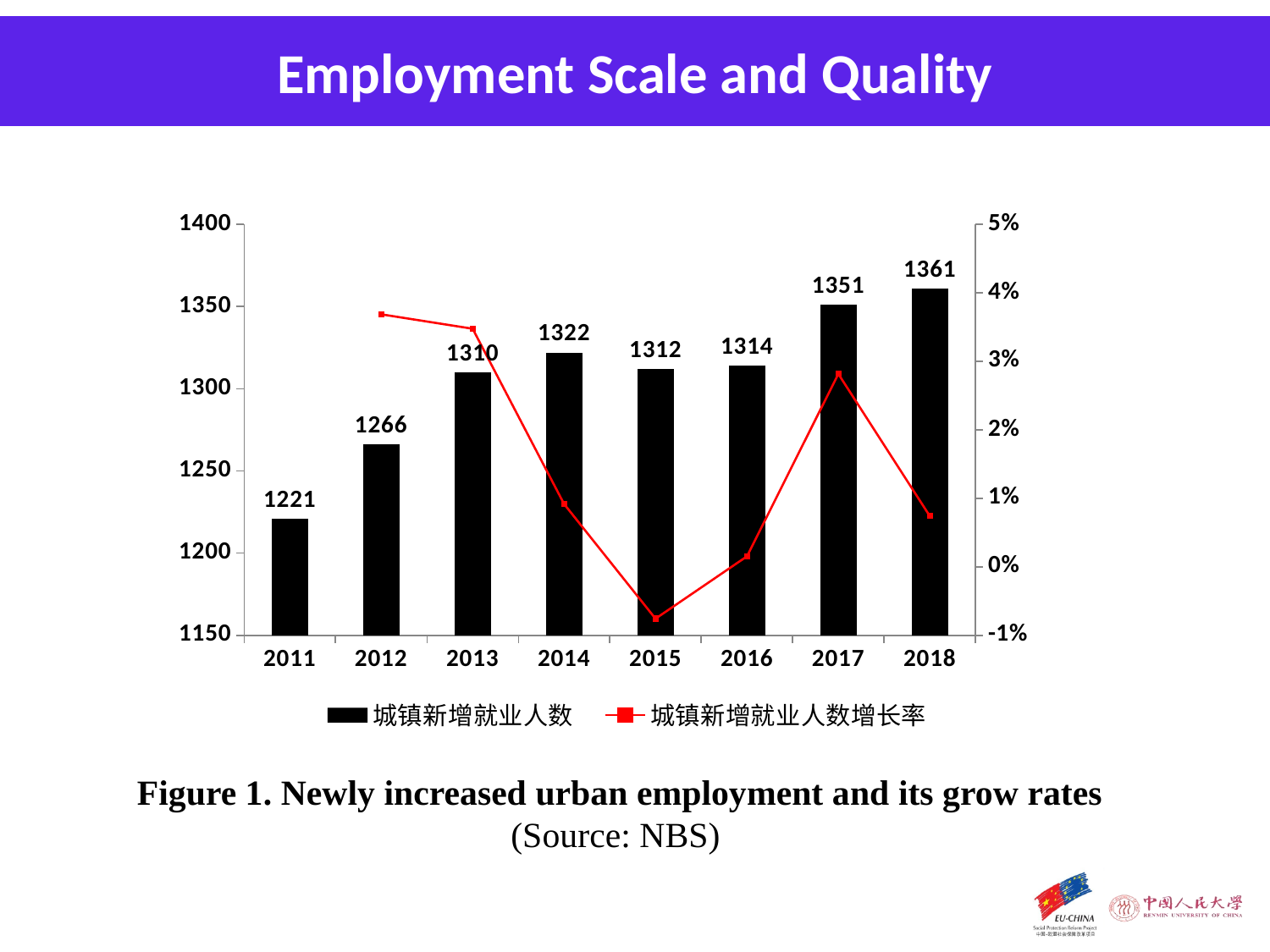
Is the growth rate (red line) for 2012 greater or less than 3%? greater What is the value of the bar for 2016? 1314 Which year has the lowest bar value? 2011 What is the difference between the bar values for 2018 and 2011? 140 What is the difference between the bar values for 2014 and 2013? 12 Which year has the highest bar value? 2018 What kind of chart is shown on the slide? Combined bar and line chart How many series does the legend list? 2 Is the growth rate (red line) for 2015 greater or less than 0%? less Which year has a larger bar value, 2012 or 2017? 2017 How many years are shown on the x axis? 8 What is the value of the bar for 2011? 1221